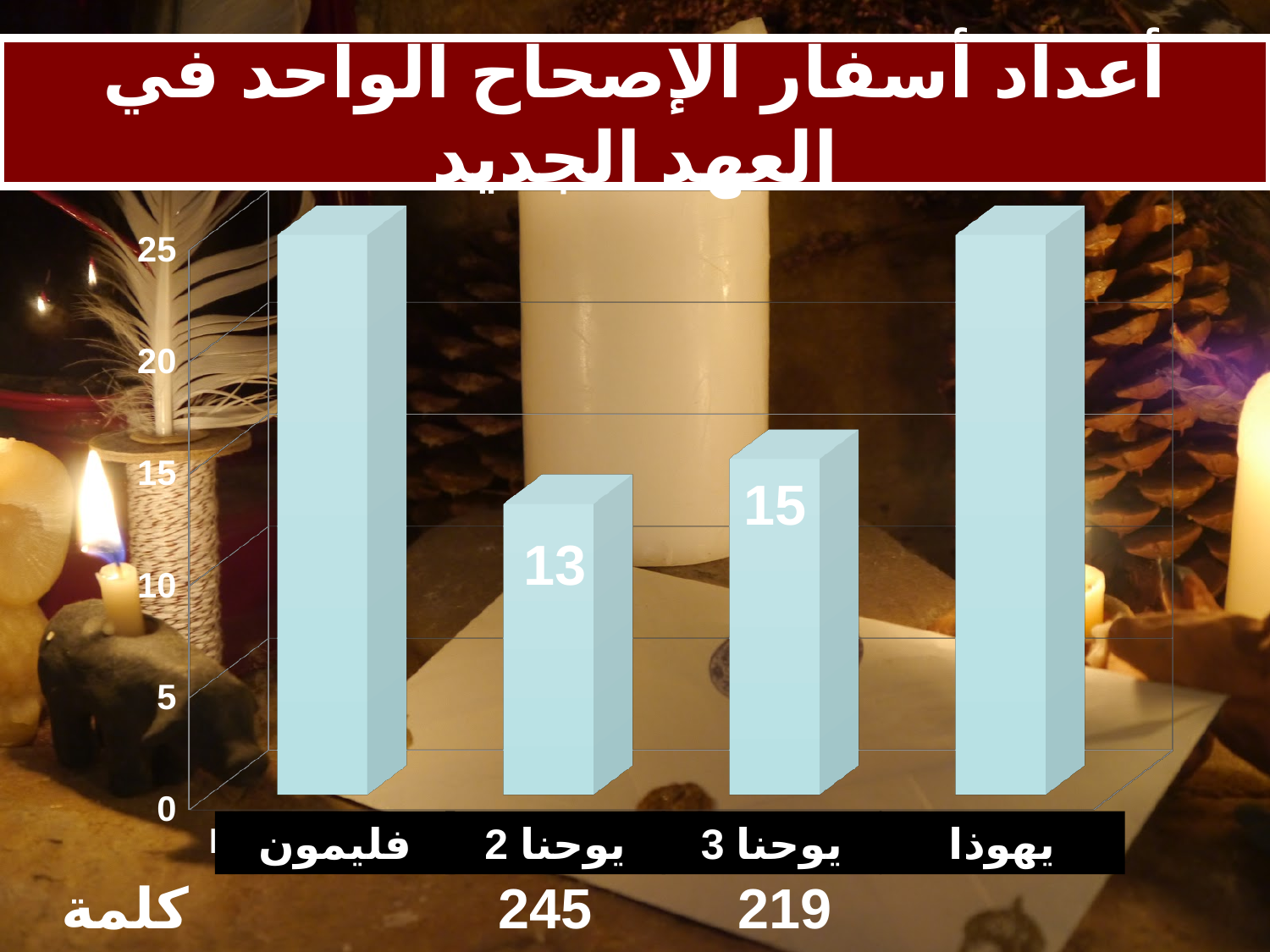
Is the value for يوحنا 3 greater or less than 20? less Which category has the lowest value in the chart? يوحنا 2 Is the value for فليمون greater or less than 20? greater What is the title of the chart on the slide? أعداد أسفار الإصحاح الواحد في العهد الجديد How many categories are shown on the x axis of the chart? 4 What is the difference between the values for يوحنا 3 and يوحنا 2? 2 What is the value for يوحنا 2 in the chart? 13 Is the value for يهوذا greater or less than 20? greater What is the value for يوحنا 3 in the chart? 15 Which has the larger value, فليمون or يوحنا 2? فليمون What kind of chart is shown on the slide? bar chart Which has the larger value, يوحنا 2 or يوحنا 3? يوحنا 3